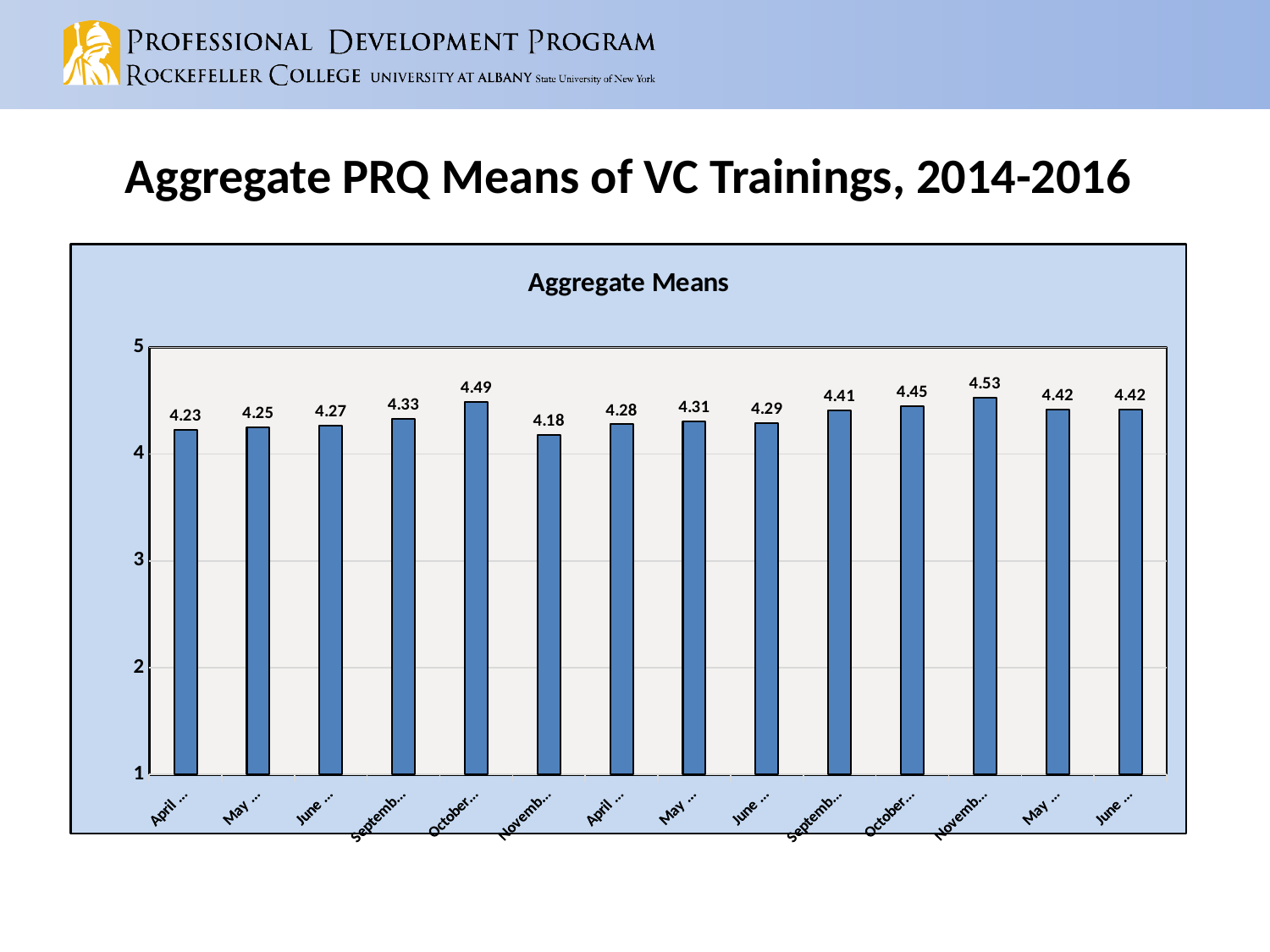
How many bars are plotted in the chart? 14 What type of chart is shown on the slide? bar chart Which is larger, the value of the first bar (4.23) or the value of the sixth bar (4.18)? the first bar (4.23) Is the value of the first bar greater or less than 4? greater What is the lowest value shown in the chart? 4.18 What is the value of the fifth bar from the left (the first October bar)? 4.49 What is the highest value shown in the chart? 4.53 What is the title of the chart on the slide? Aggregate Means What is the value of the last (rightmost) bar in the chart? 4.42 What is the difference between the fourth bar (4.33) and the third bar (4.27)? 0.06 What is the value of the first (leftmost) bar in the chart? 4.23 What is the difference between the highest value (4.53) and the lowest value (4.18) in the chart? 0.35